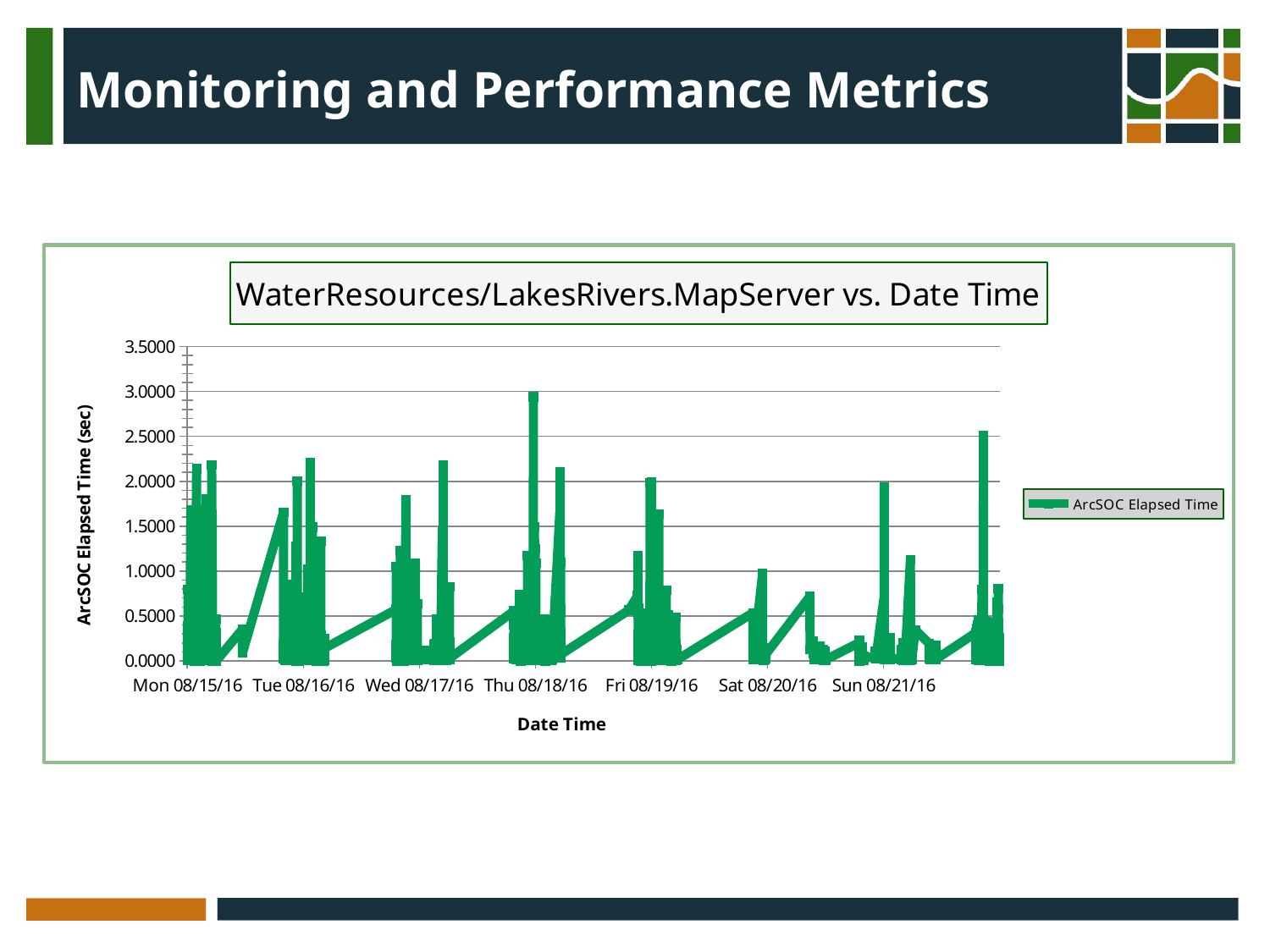
How many series does the legend list? 1 Is the highest spike on Sat 08/20/16 greater or less than 1.5000? less What kind of chart is shown on the slide? line chart Which is larger, the peak ArcSOC Elapsed Time on Thu 08/18/16 or on Sat 08/20/16? Thu 08/18/16 How many date labels are shown along the x axis? 7 Is the highest value on the chart greater or less than 3.5000? less What is the name of the series shown in the legend? ArcSOC Elapsed Time Is the highest spike on Thu 08/18/16 greater or less than 2.5000? greater On which date is the highest spike the lowest compared with the other days? Sat 08/20/16 On which date does the highest spike in ArcSOC Elapsed Time occur? Thu 08/18/16 What is the title of the chart? WaterResources/LakesRivers.MapServer vs. Date Time